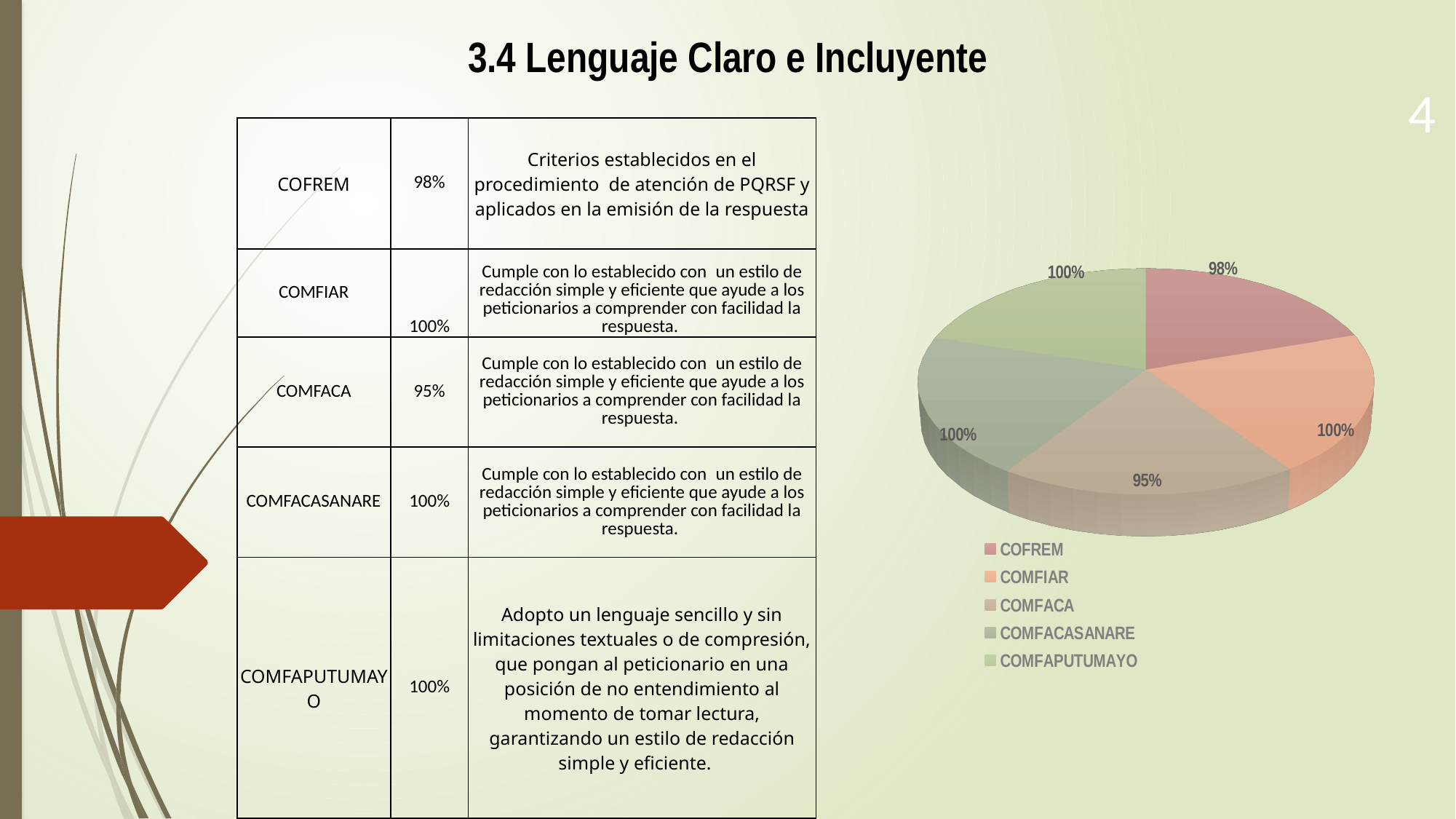
What is the value shown for COFREM in the pie chart? 98% What is the difference between the values for COFREM and COMFACA in the pie chart? 3% What is the value shown for COMFACA in the pie chart? 95% What is the value shown for COMFACASANARE in the pie chart? 100% Which legend entry is listed last in the pie chart's legend? COMFAPUTUMAYO Which category has the lowest value in the pie chart? COMFACA What is the value shown for COMFAPUTUMAYO in the pie chart? 100% What is the value shown for COMFIAR in the pie chart? 100% How many entries does the pie chart's legend list? 5 How many slices does the pie chart have? 5 Which is larger in the pie chart, the value for COFREM or the value for COMFACA? COFREM What kind of chart is shown on the slide? pie chart